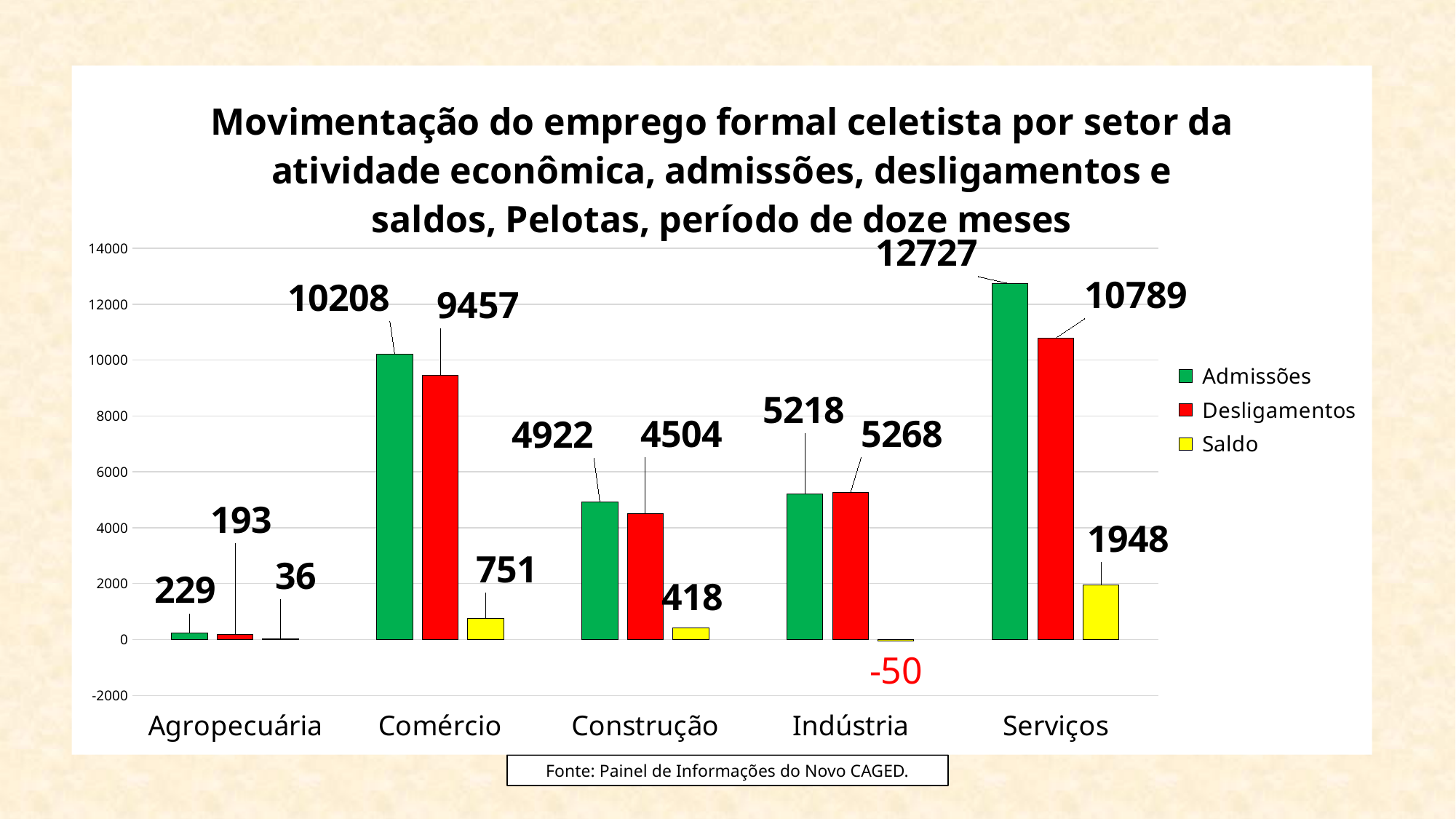
What kind of chart is shown on the slide? bar chart Which sector has the highest Admissões value? Serviços What is the difference between Admissões and Desligamentos for Serviços? 1938 What is the value of Desligamentos for Construção? 4504 Which sector has the lowest Desligamentos value? Agropecuária What is the value of Admissões for Comércio? 10208 How many series does the legend list? 3 Which series is shown in yellow in the legend? Saldo How many sectors are shown on the x axis? 5 What is the Saldo value for Indústria? -50 For Indústria, which is larger: Admissões or Desligamentos? Desligamentos Is the Admissões value for Comércio greater or less than 10000? greater